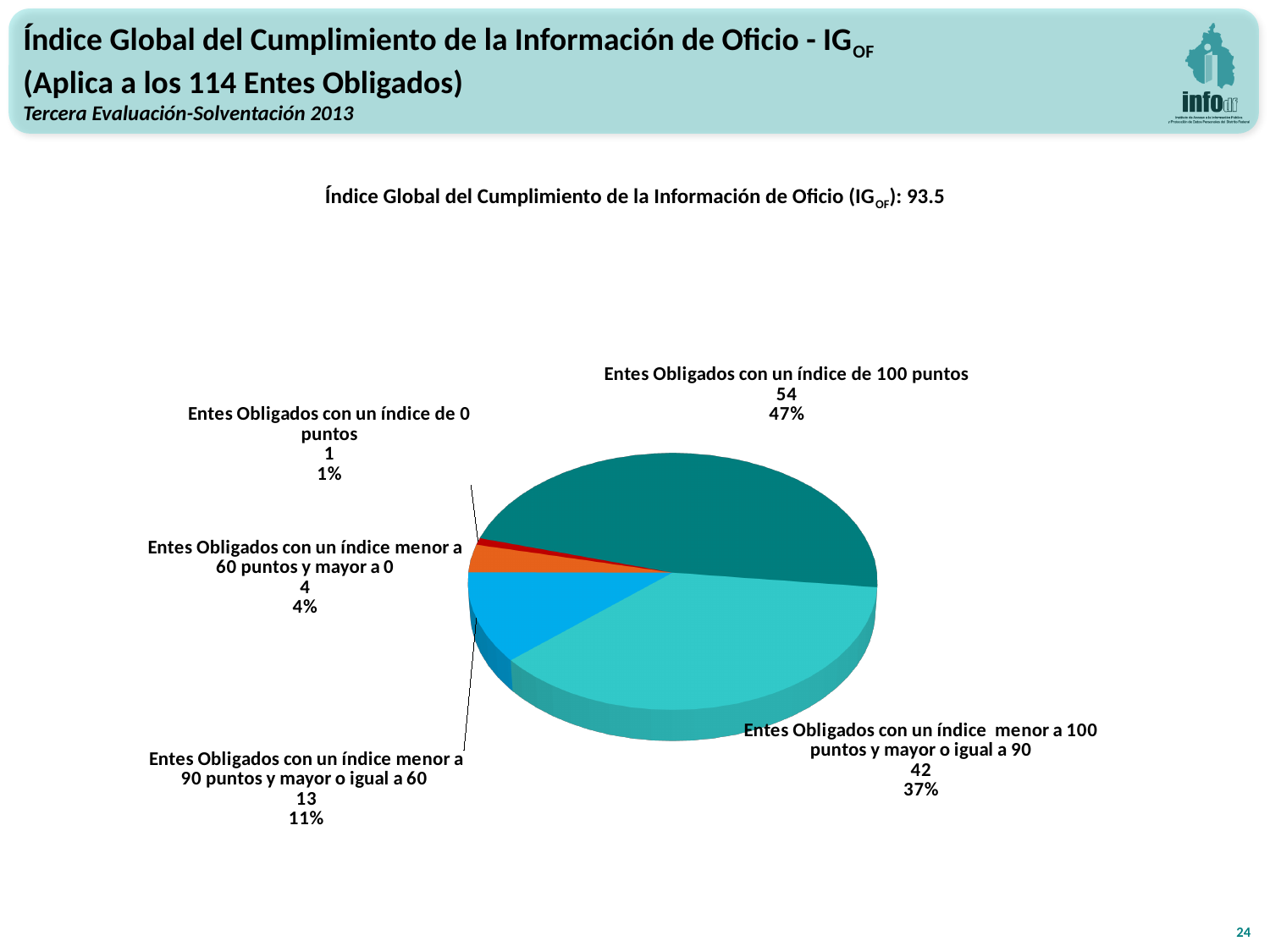
How many Entes Obligados have an index less than 90 points and greater than or equal to 60? 13 Which category has the largest slice of the pie? Entes Obligados con un índice de 100 puntos Which is larger: the number of Entes Obligados with an index less than 90 and greater than or equal to 60, or those with an index less than 60 and greater than 0? Entes Obligados con un índice menor a 90 puntos y mayor o igual a 60 How many Entes Obligados have an index less than 60 points and greater than 0? 4 What value of the Índice Global del Cumplimiento de la Información de Oficio (IGOF) is stated above the chart? 93.5 Which category has the smallest slice of the pie? Entes Obligados con un índice de 0 puntos What percentage of the pie corresponds to Entes Obligados with an index of 0 points? 1% How many categories does the pie chart have? 5 What is the difference between the number of Entes Obligados with an index of 100 points and those with an index less than 100 and greater than or equal to 90? 12 What percentage of the pie corresponds to Entes Obligados with an index less than 100 points and greater than or equal to 90? 37% How many Entes Obligados have an index of 100 points? 54 What kind of chart is shown on the slide? pie chart